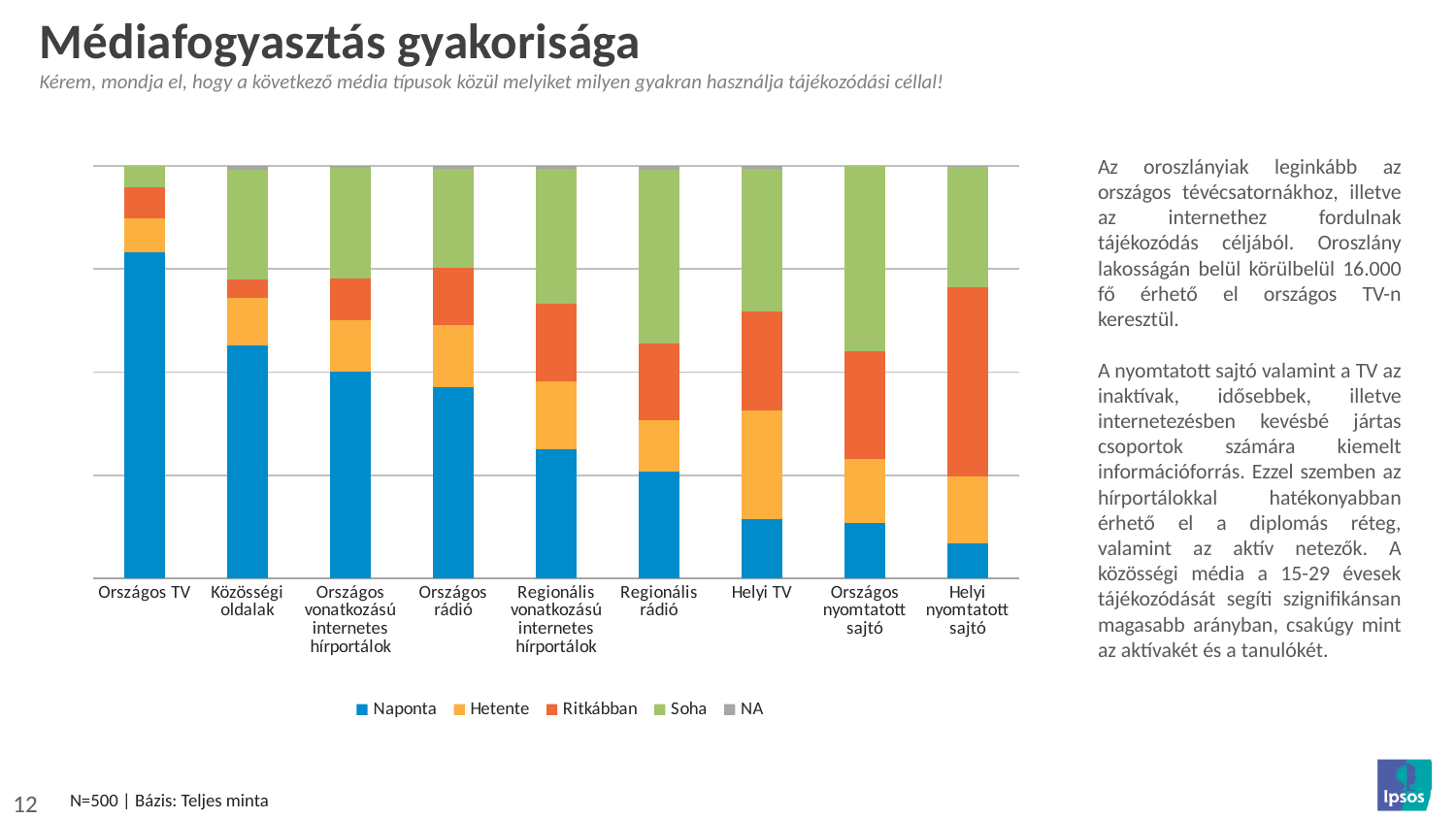
Which category has the smallest 'Naponta' segment? Helyi nyomtatott sajtó How many series does the chart legend list? 5 Which legend entry is shown in blue? Naponta Which has the larger 'Soha' segment: Országos TV or Helyi TV? Helyi TV Which category has the smallest 'Soha' segment? Országos TV What kind of chart is shown on the slide? stacked bar chart Does the 'Naponta' segment rise or fall moving from left to right across the categories? fall Which category has the largest 'Ritkábban' segment? Helyi nyomtatott sajtó How many media types (categories) are shown on the x axis of the chart? 9 Which has the larger 'Naponta' segment: Országos TV or Közösségi oldalak? Országos TV What is the title of the slide containing the chart? Médiafogyasztás gyakorisága Which category has the largest 'Naponta' segment? Országos TV